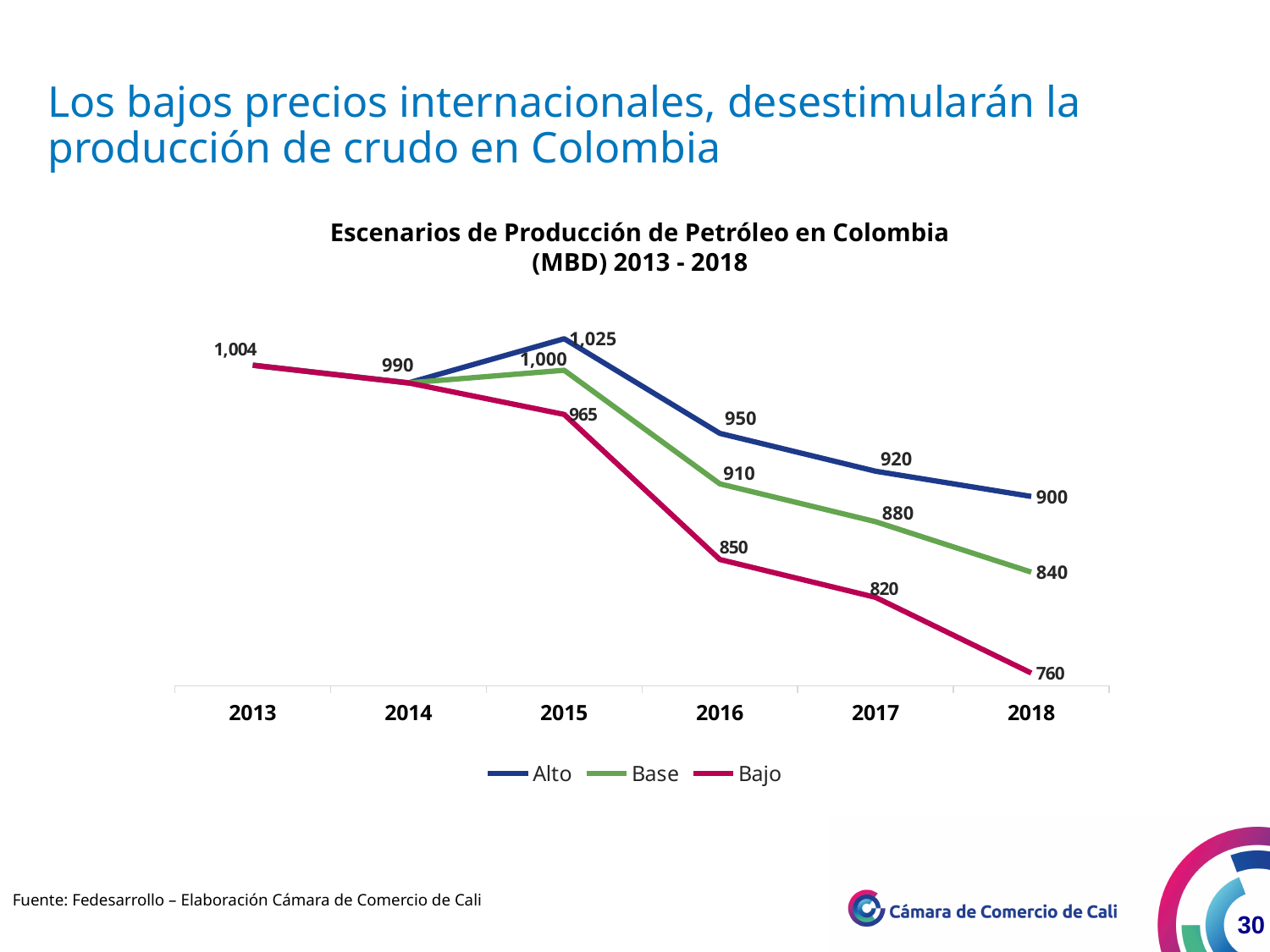
What is the value of the Bajo series in 2018? 760 How many series does the legend list? 3 How many years are shown on the x axis? 6 Which is larger in 2016, the Base value or the Bajo value? Base What type of chart is shown on the slide? line chart What is the difference between the Alto and Bajo values in 2018? 140 Does the Bajo series rise or fall from 2015 to 2018? fall In which year does the Alto series reach its highest value? 2015 Which series has the lowest value in 2018? Bajo What is the value of the Alto series in 2015? 1,025 What is the value shown for 2013? 1,004 What is the value of the Base series in 2017? 880